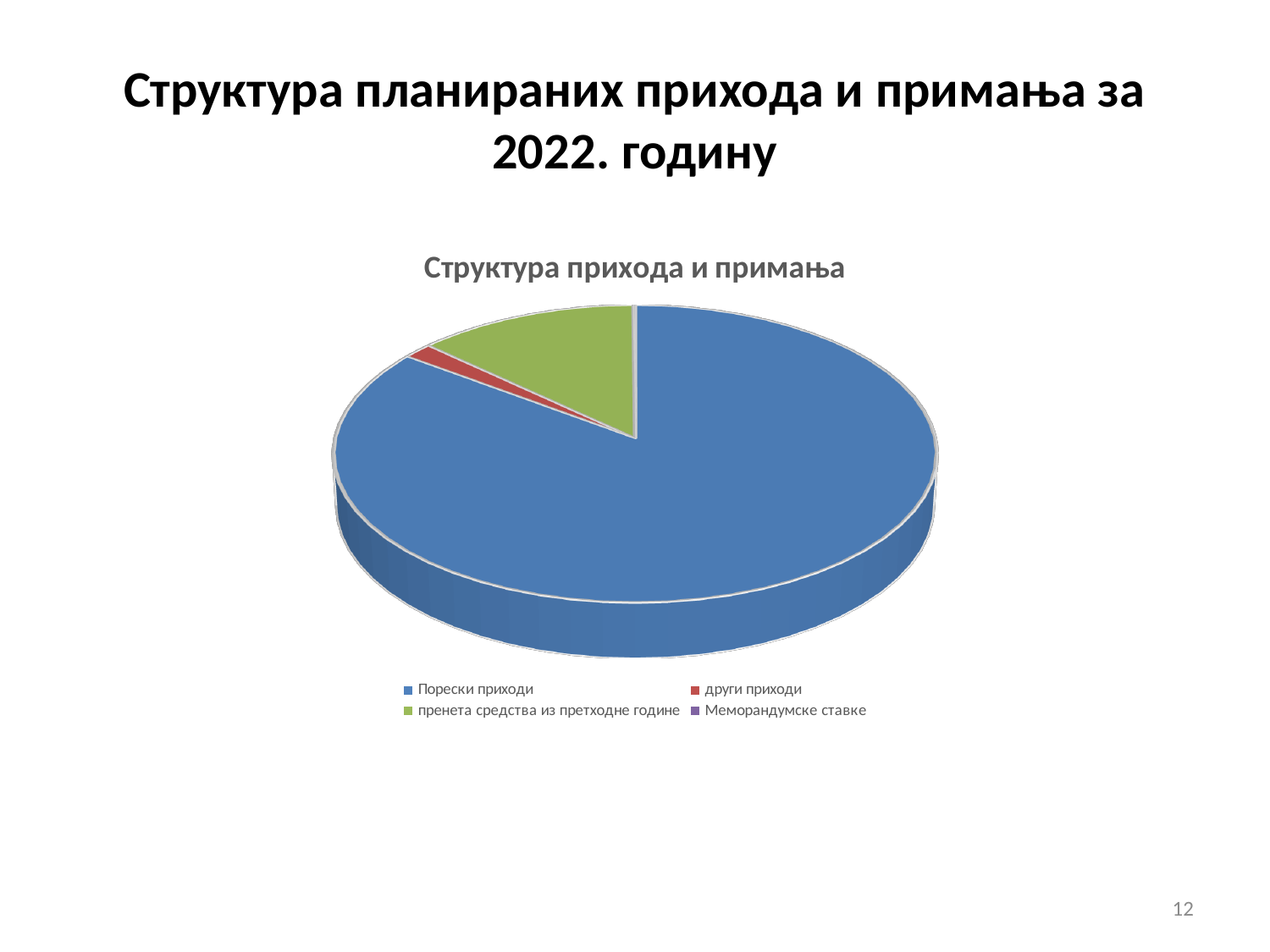
How many categories does the chart legend list? 4 Which slice is larger: Порески приходи or пренета средства из претходне године? Порески приходи What is the title of the chart on the slide? Структура прихода и примања What colour is the slice for Порески приходи? blue Which slice is larger: пренета средства из претходне године or други приходи? пренета средства из претходне године Which slice is larger: други приходи or Порески приходи? Порески приходи Does the slice for Порески приходи take up more or less than half of the pie? more Which category has the largest slice of the pie? Порески приходи What kind of chart is shown on the slide? pie chart